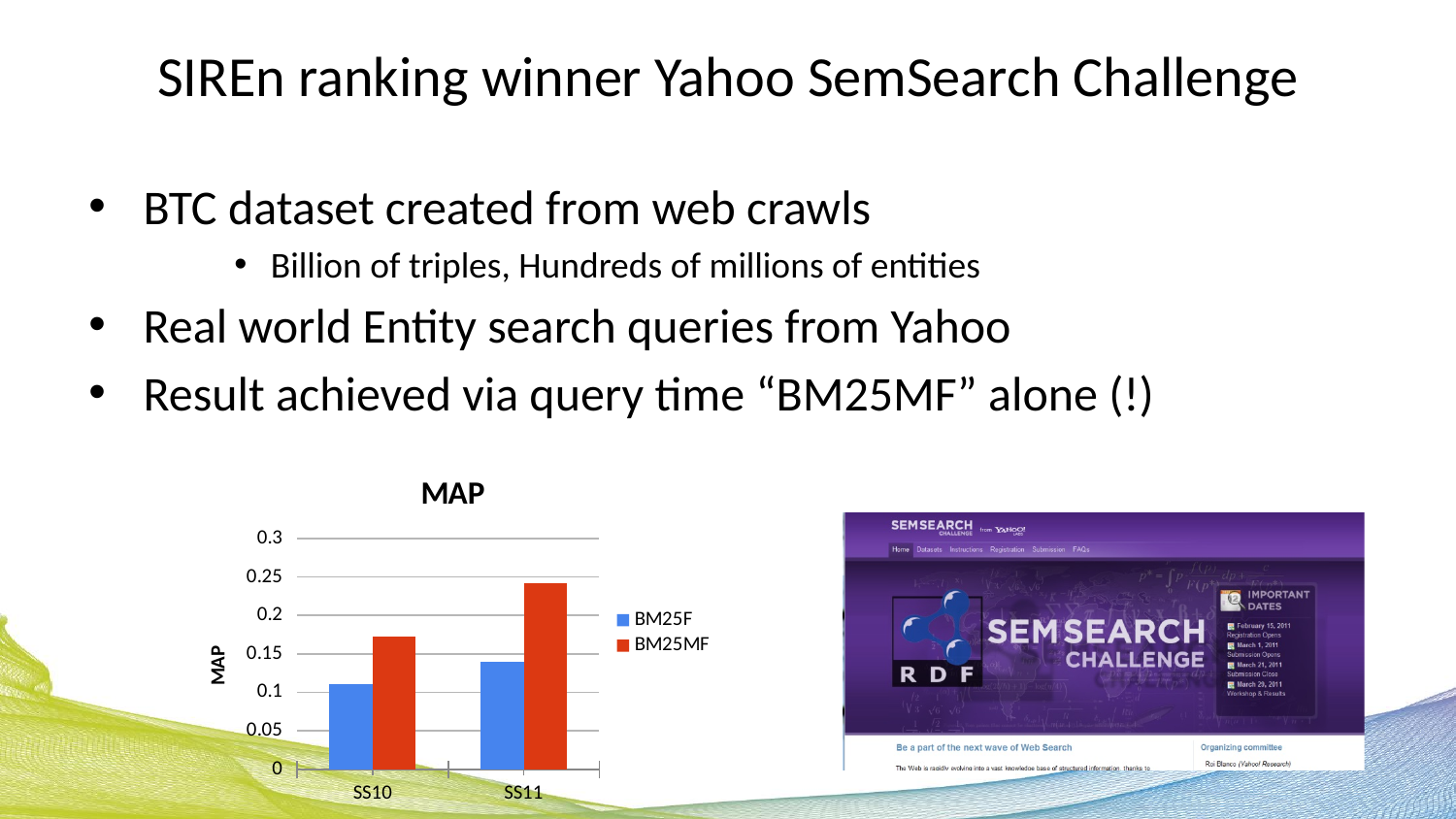
For SS10, which series has the larger MAP value, BM25F or BM25MF? BM25MF Is the value for BM25MF at SS11 greater or less than 0.2? greater For SS11, which series has the larger MAP value, BM25F or BM25MF? BM25MF What colour are the BM25MF bars in the chart? red How many series does the chart legend list? 2 What is the title of the chart? MAP What type of chart is shown on the slide? bar chart Does the MAP value for BM25MF rise or fall from SS10 to SS11? rise Which series and category has the lowest bar in the chart? BM25F at SS10 How many categories are shown on the x axis of the chart? 2 Is the value for BM25F at SS10 greater or less than 0.15? less Which series and category has the highest bar in the chart? BM25MF at SS11